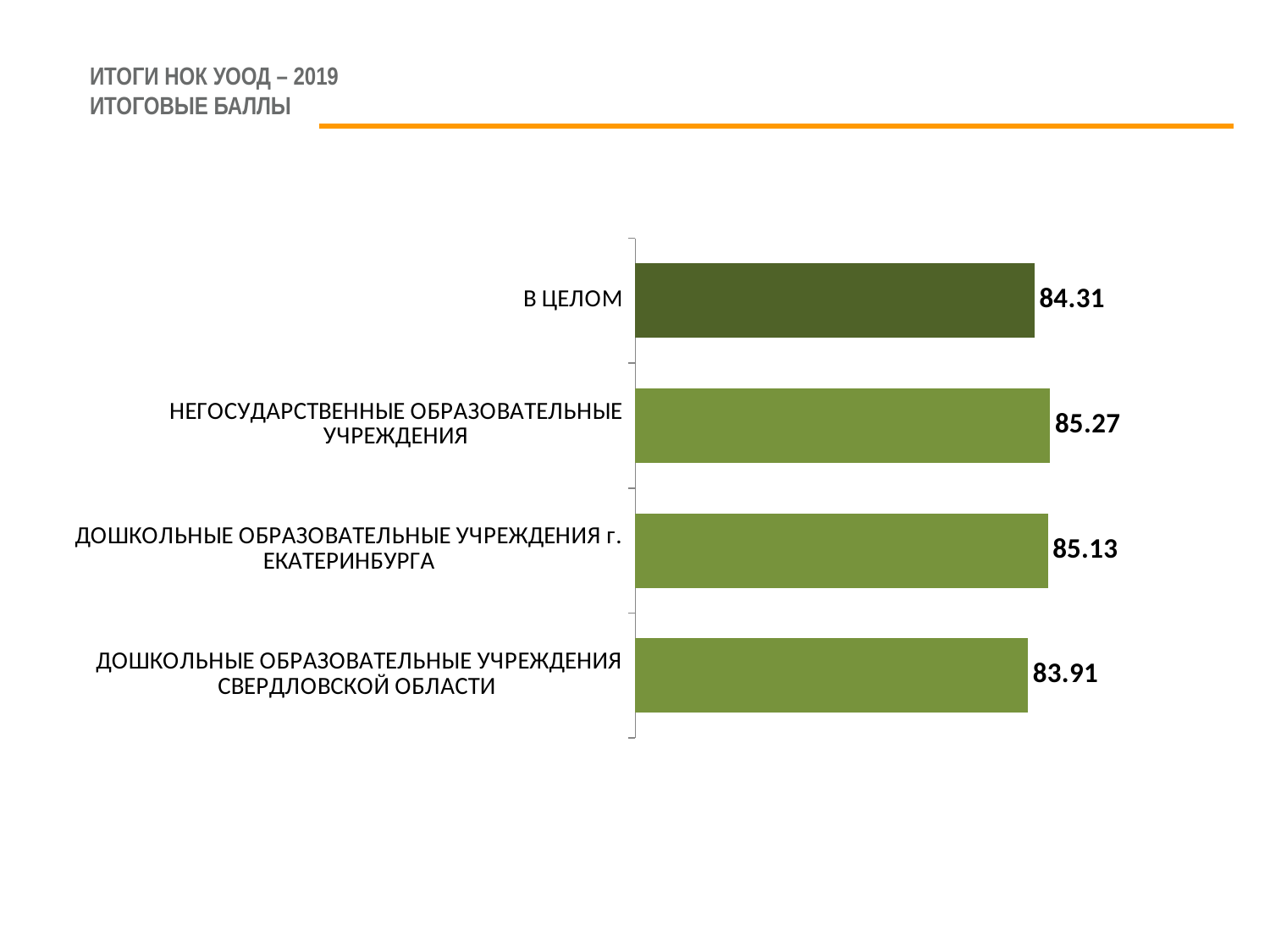
What is the value for ДОШКОЛЬНЫЕ ОБРАЗОВАТЕЛЬНЫЕ УЧРЕЖДЕНИЯ г. ЕКАТЕРИНБУРГА? 85.13 What is the value for В ЦЕЛОМ? 84.31 What kind of chart is shown on the slide? Bar chart Which is larger: the value for В ЦЕЛОМ or the value for ДОШКОЛЬНЫЕ ОБРАЗОВАТЕЛЬНЫЕ УЧРЕЖДЕНИЯ СВЕРДЛОВСКОЙ ОБЛАСТИ? В ЦЕЛОМ What is the value for ДОШКОЛЬНЫЕ ОБРАЗОВАТЕЛЬНЫЕ УЧРЕЖДЕНИЯ СВЕРДЛОВСКОЙ ОБЛАСТИ? 83.91 Which category has the highest value? НЕГОСУДАРСТВЕННЫЕ ОБРАЗОВАТЕЛЬНЫЕ УЧРЕЖДЕНИЯ What is the title text at the top of the slide? ИТОГИ НОК УООД – 2019 ИТОГОВЫЕ БАЛЛЫ What is the difference between the values for ДОШКОЛЬНЫЕ ОБРАЗОВАТЕЛЬНЫЕ УЧРЕЖДЕНИЯ г. ЕКАТЕРИНБУРГА and В ЦЕЛОМ? 0.82 What is the difference between the values for НЕГОСУДАРСТВЕННЫЕ ОБРАЗОВАТЕЛЬНЫЕ УЧРЕЖДЕНИЯ and ДОШКОЛЬНЫЕ ОБРАЗОВАТЕЛЬНЫЕ УЧРЕЖДЕНИЯ СВЕРДЛОВСКОЙ ОБЛАСТИ? 1.36 How many categories are shown in the chart? 4 Which category has the lowest value? ДОШКОЛЬНЫЕ ОБРАЗОВАТЕЛЬНЫЕ УЧРЕЖДЕНИЯ СВЕРДЛОВСКОЙ ОБЛАСТИ What is the value for НЕГОСУДАРСТВЕННЫЕ ОБРАЗОВАТЕЛЬНЫЕ УЧРЕЖДЕНИЯ? 85.27